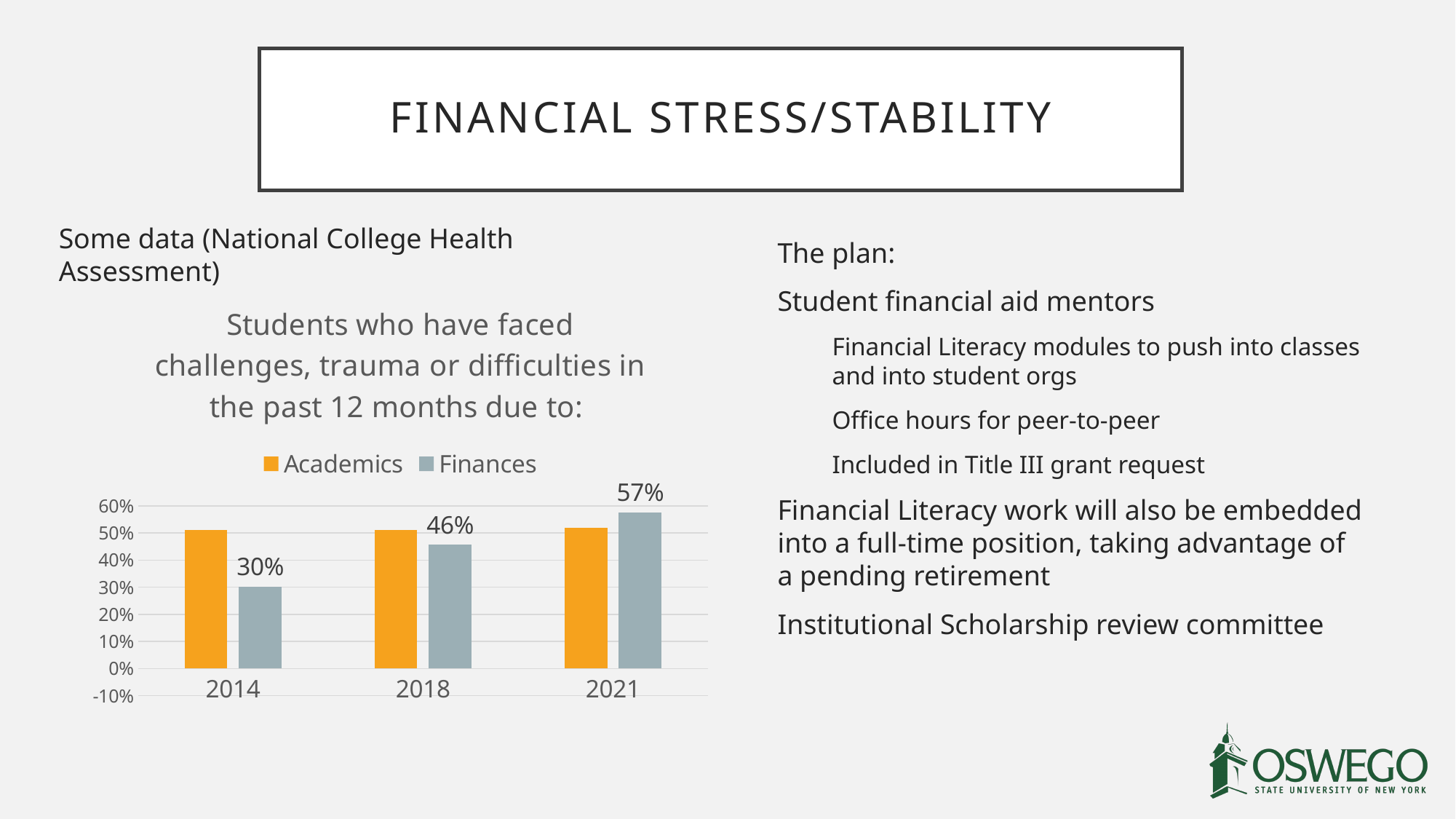
In which year is the Finances value highest? 2021 Is the value for Academics in 2014 greater or less than 40%? greater How many years are shown on the x axis of the chart? 3 In which year is the Finances value lowest? 2014 What is the value for Finances in 2018? 46% What is the value for Finances in 2021? 57% How many series does the chart's legend list? 2 In 2014, which is larger: Academics or Finances? Academics In 2021, which is larger: Academics or Finances? Finances What is the value for Finances in 2014? 30% What is the difference between the Finances values for 2021 and 2014? 27 percentage points What kind of chart is shown on the slide? bar chart